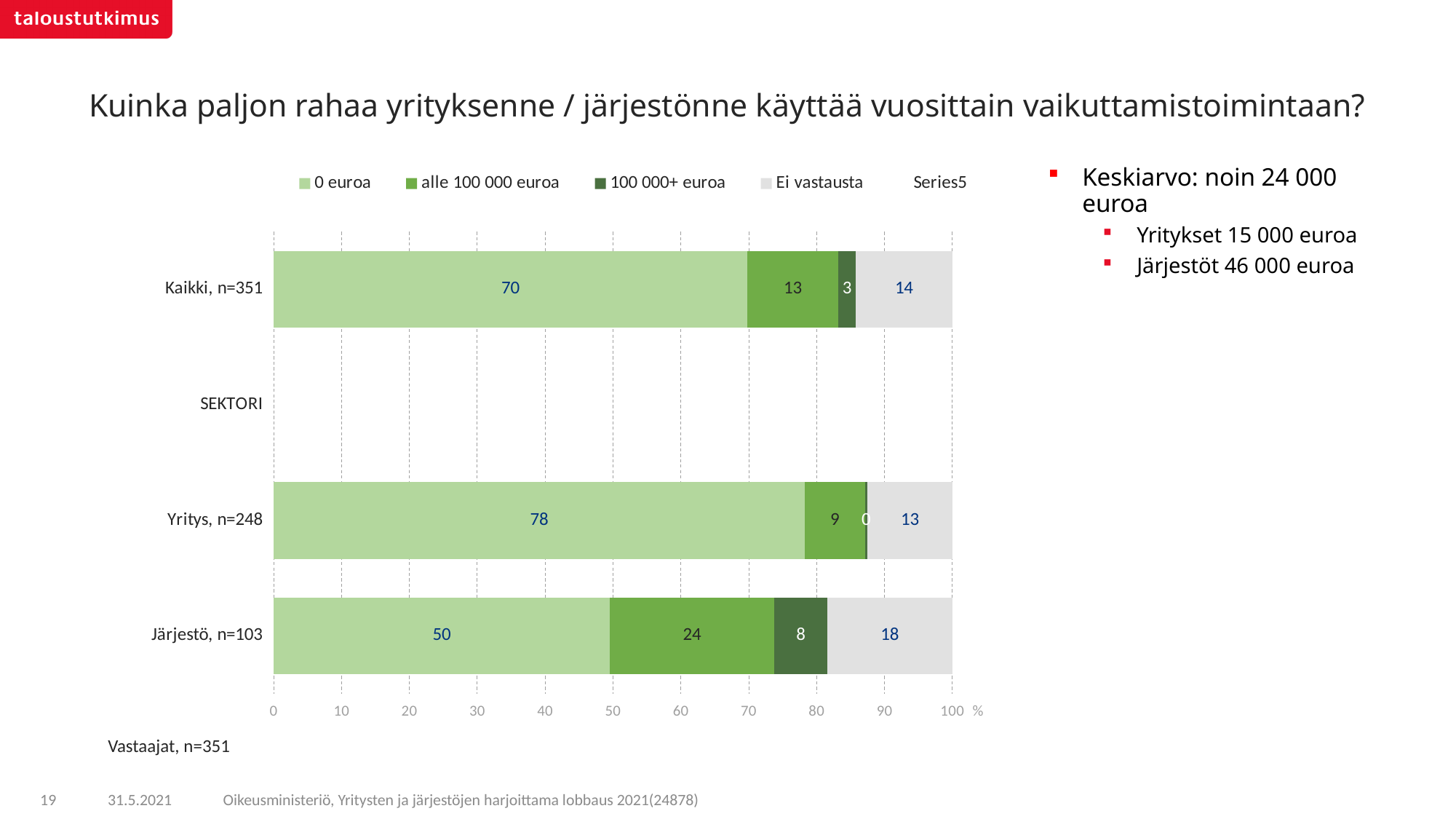
What is the total of the Järjestö, n=103 stacked bar? 100 What is the value for "100 000+ euroa" in the Yritys, n=248 bar? 0 What is the value for "alle 100 000 euroa" in the Järjestö, n=103 bar? 24 What is the value for "0 euroa" in the Kaikki, n=351 bar? 70 What is the difference between the "0 euroa" values for Yritys, n=248 and Järjestö, n=103? 28 Which category has the highest value for "0 euroa"? Yritys, n=248 How many entries does the chart legend list? 5 What is the value for "Ei vastausta" in the Yritys, n=248 bar? 13 What colour represents the "Ei vastausta" series in the chart? Light grey What kind of chart is shown on the slide? Stacked bar chart Which is larger: the "Ei vastausta" value for Järjestö, n=103 or for Kaikki, n=351? Järjestö, n=103 Which category has the lowest value for "100 000+ euroa"? Yritys, n=248